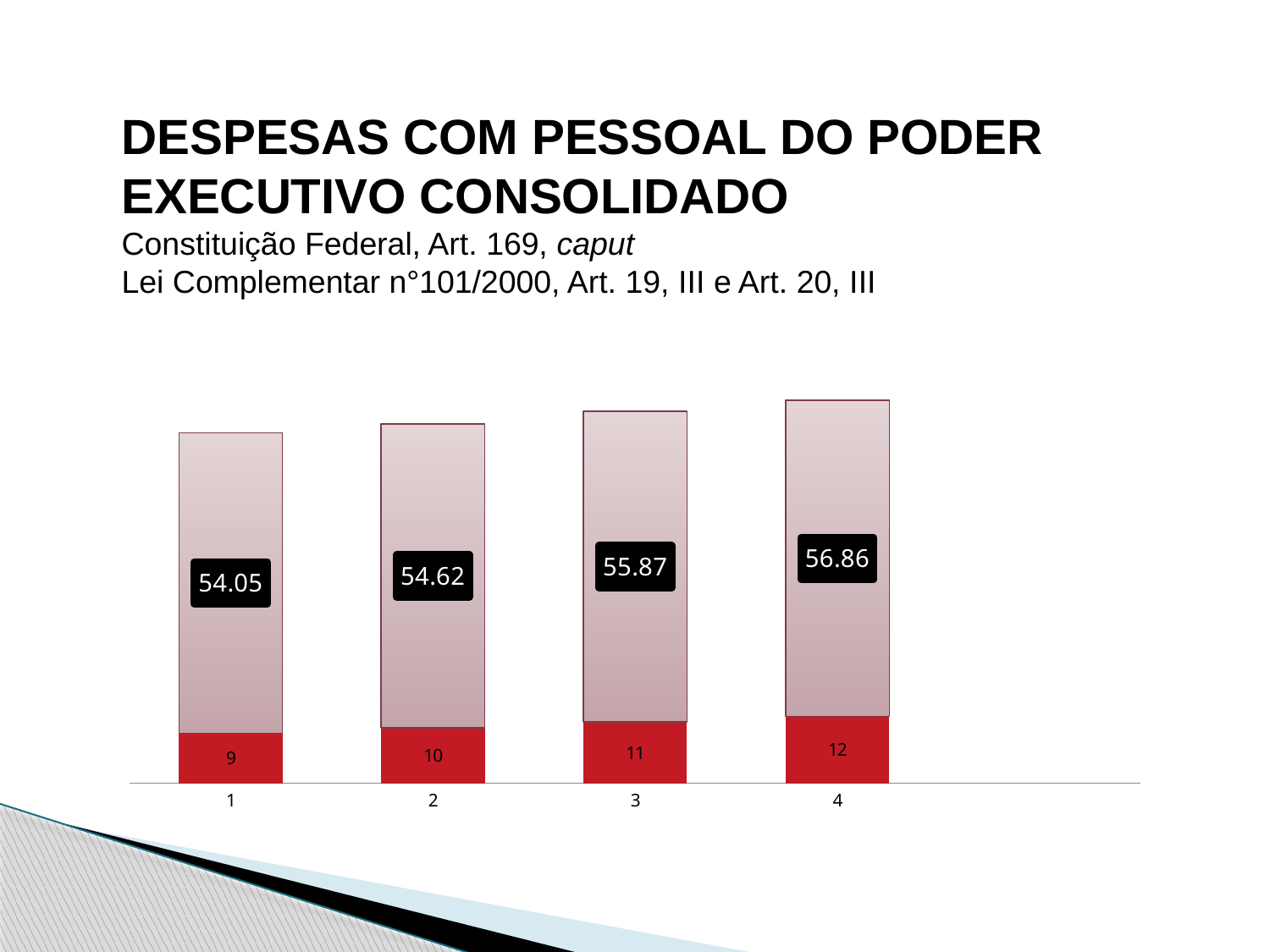
Do the upper segment values rise or fall from bar 1 to bar 4? rise What is the total of the two segments of bar 2? 64.62 What is the total of the two segments of bar 4? 68.86 Which bar has the highest value in its upper (pink) segment? 4 What type of chart is shown on the slide? stacked bar chart How many bars (categories) are shown in the chart? 4 Which is larger, the upper segment value of bar 2 or of bar 3? bar 3 What is the value of the upper (pink) segment of bar 3? 55.87 Which bar has the lowest value in its lower (red) segment? 1 What is the value of the upper (pink) segment of bar 1? 54.05 What is the value of the lower (red) segment of bar 4? 12 What is the difference between the upper segment values of bar 4 and bar 1? 2.81